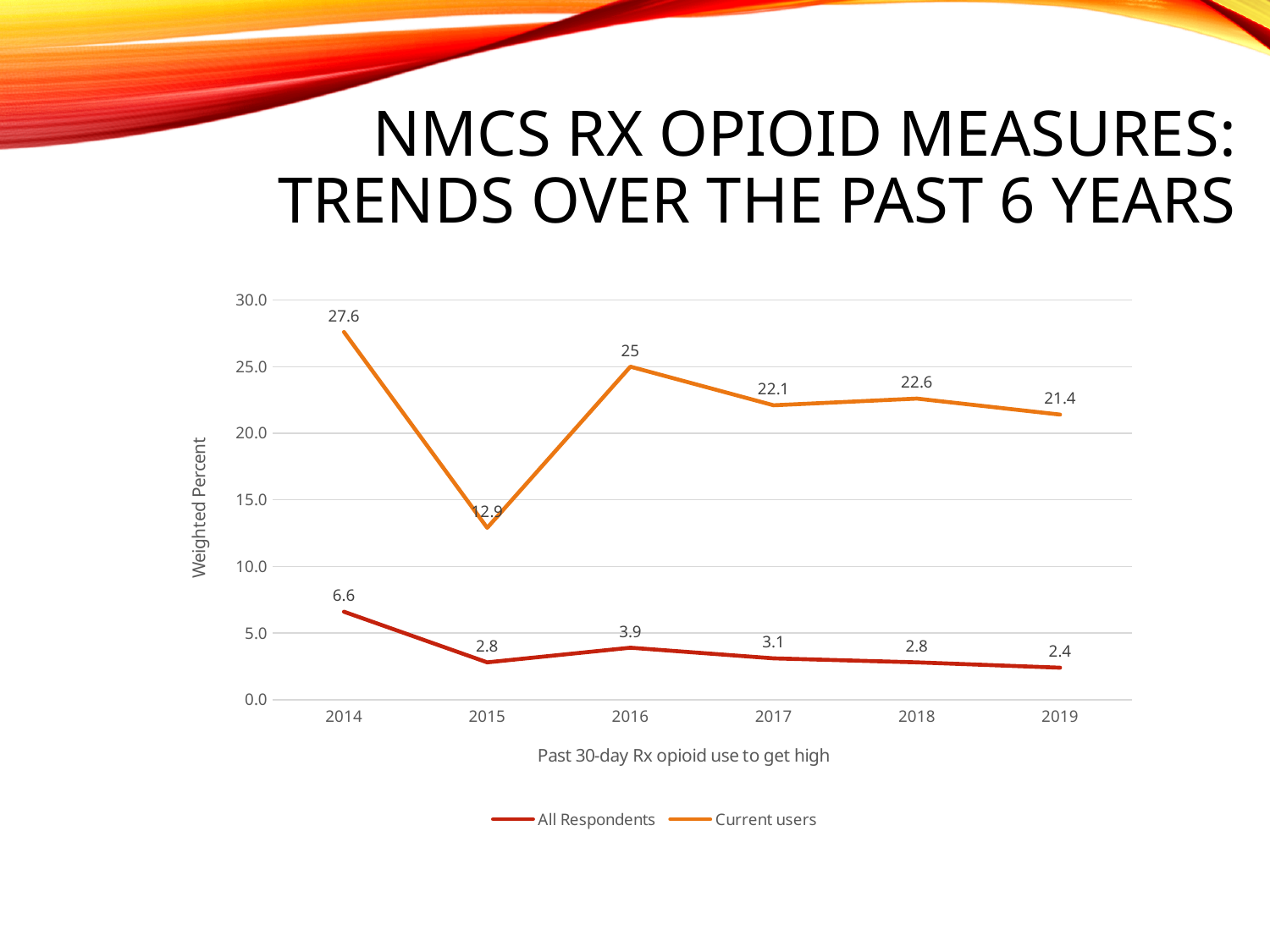
Is the Current users value in 2015 greater or less than 15.0? less What is the difference between the Current users and All Respondents values in 2019? 19 In which year is the Current users value lowest? 2015 What is the value for Current users in 2014? 27.6 How many years are shown on the x axis? 6 Which is larger, the Current users value in 2018 or in 2017? 2018 In which year is the All Respondents value highest? 2014 What is the value for Current users in 2016? 25 How many series does the legend list? 2 What is the value for All Respondents in 2019? 2.4 What kind of chart is shown on the slide? line chart What is the difference between the Current users value in 2014 and in 2015? 14.7